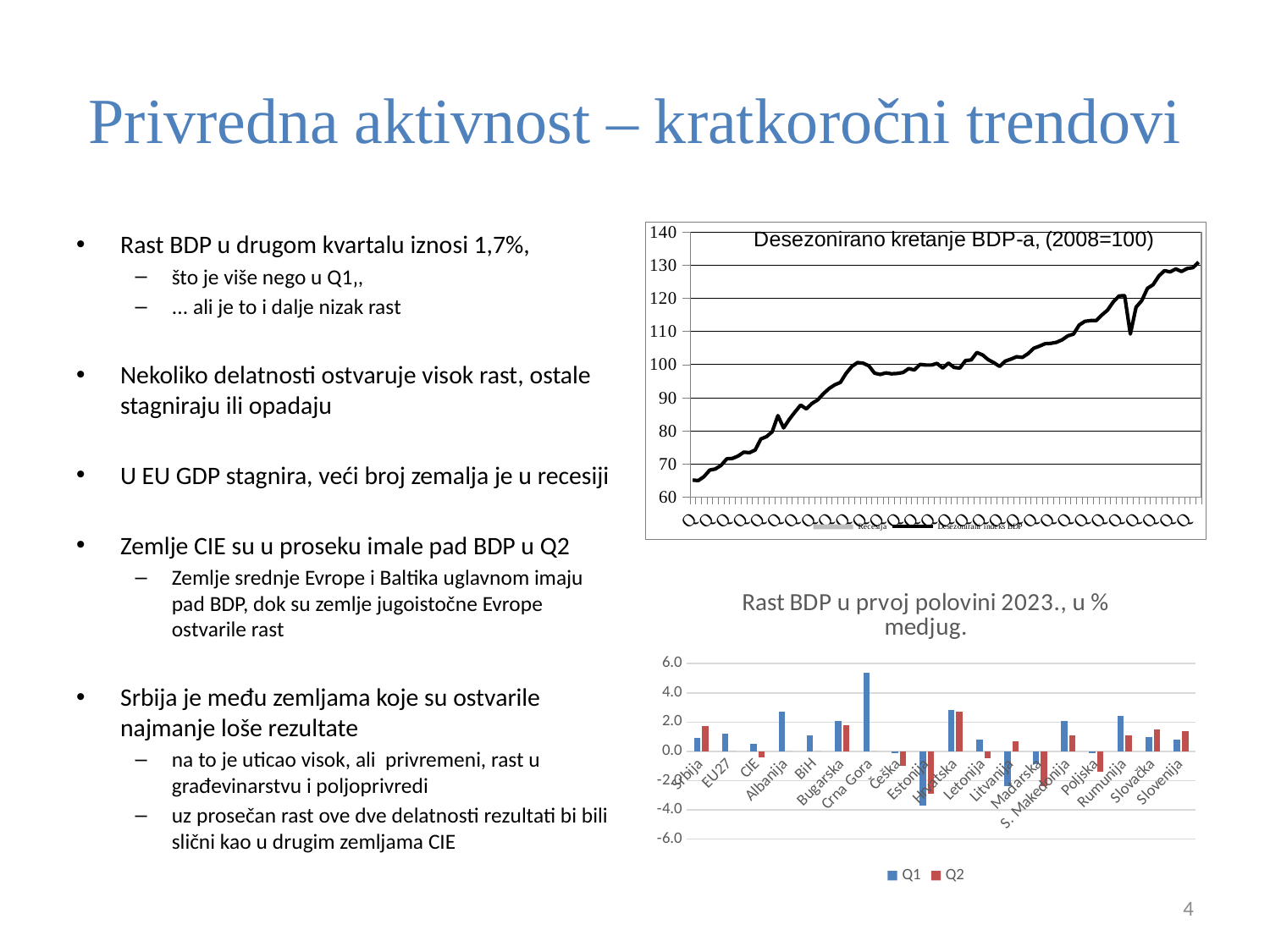
In the chart 'Rast BDP u prvoj polovini 2023., u % medjug.', is the Q1 value for Estonija greater or less than -2.0? less In the chart 'Rast BDP u prvoj polovini 2023., u % medjug.', is the Q2 value for Srbija greater or less than 1.0? greater In the chart 'Rast BDP u prvoj polovini 2023., u % medjug.', which is larger, the Q1 value for Crna Gora or the Q1 value for Albanija? Crna Gora In the chart 'Rast BDP u prvoj polovini 2023., u % medjug.', is the Q1 value for Crna Gora greater or less than 4.0? greater In the chart 'Rast BDP u prvoj polovini 2023., u % medjug.', how many countries/categories are shown on the x axis? 18 What kind of chart is the chart titled 'Rast BDP u prvoj polovini 2023., u % medjug.'? bar chart In the chart 'Rast BDP u prvoj polovini 2023., u % medjug.', which category has the lowest Q1 value? Estonija In the chart 'Desezonirano kretanje BDP-a, (2008=100)', do the values generally rise or fall along the x axis? rise In the chart 'Rast BDP u prvoj polovini 2023., u % medjug.', how many series does the legend list? 2 What kind of chart is the chart titled 'Desezonirano kretanje BDP-a, (2008=100)'? line chart In the chart 'Rast BDP u prvoj polovini 2023., u % medjug.', which category has the highest Q1 value? Crna Gora